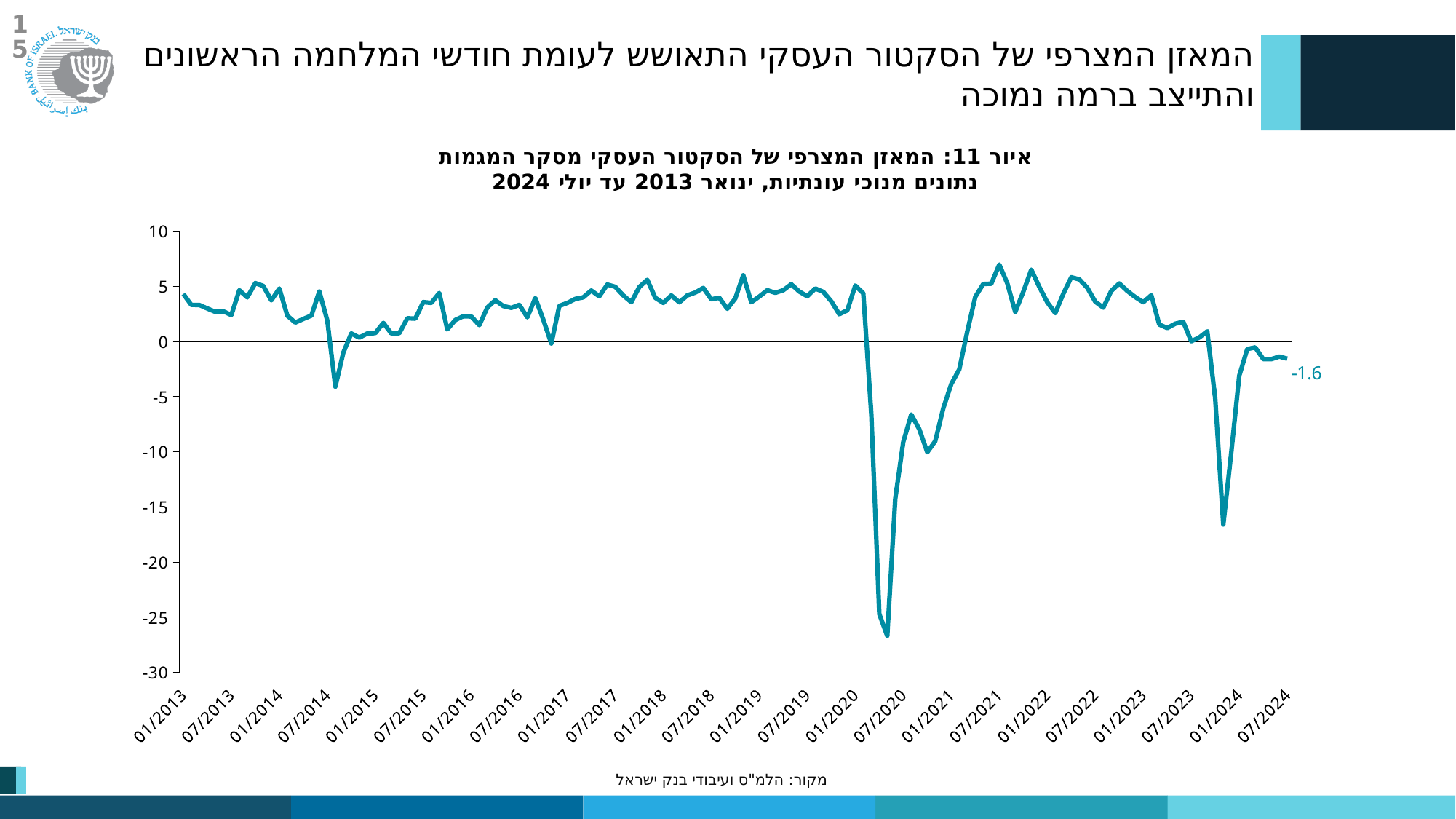
Which is larger, the value at 01/2013 or the value at 07/2024? 01/2013 What is the highest value shown on the y axis? 10 Is the lowest point of the line greater or less than -20? less How many lines (series) are plotted on the chart? 1 How many date labels are shown on the x axis? 24 Is the value at 01/2013 greater or less than 0? greater Around which x-axis label does the line reach its lowest point? 07/2020 Is the value at 07/2024 greater or less than 0? less Does the line end higher or lower than it starts? lower What kind of chart is shown on the slide? Line chart What value is labelled at the end of the line, at 07/2024? -1.6